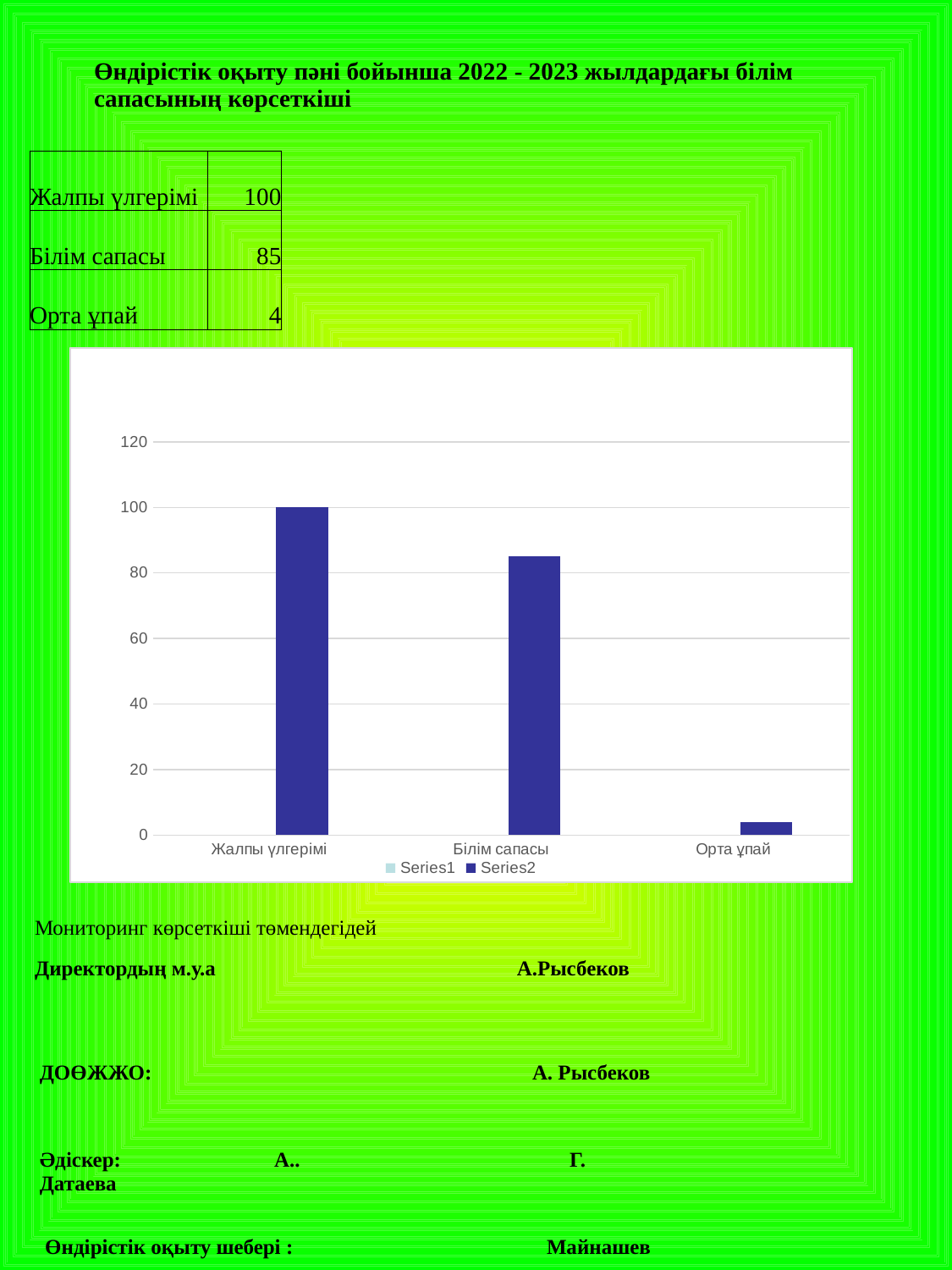
What is the value for Орта ұпай? 4 Which is larger, the value for Білім сапасы or the value for Орта ұпай? Білім сапасы What kind of chart is shown on the slide? bar chart How many series does the chart legend list? 2 How many categories are shown on the x axis of the chart? 3 What is the difference between the values for Жалпы үлгерімі and Білім сапасы? 15 Which category has the highest bar in the chart? Жалпы үлгерімі Which category has the lowest bar in the chart? Орта ұпай Is the value for Білім сапасы greater or less than 80? greater What is the value for Білім сапасы? 85 Do the bar values rise or fall from left to right along the x axis? fall What is the value for Жалпы үлгерімі? 100